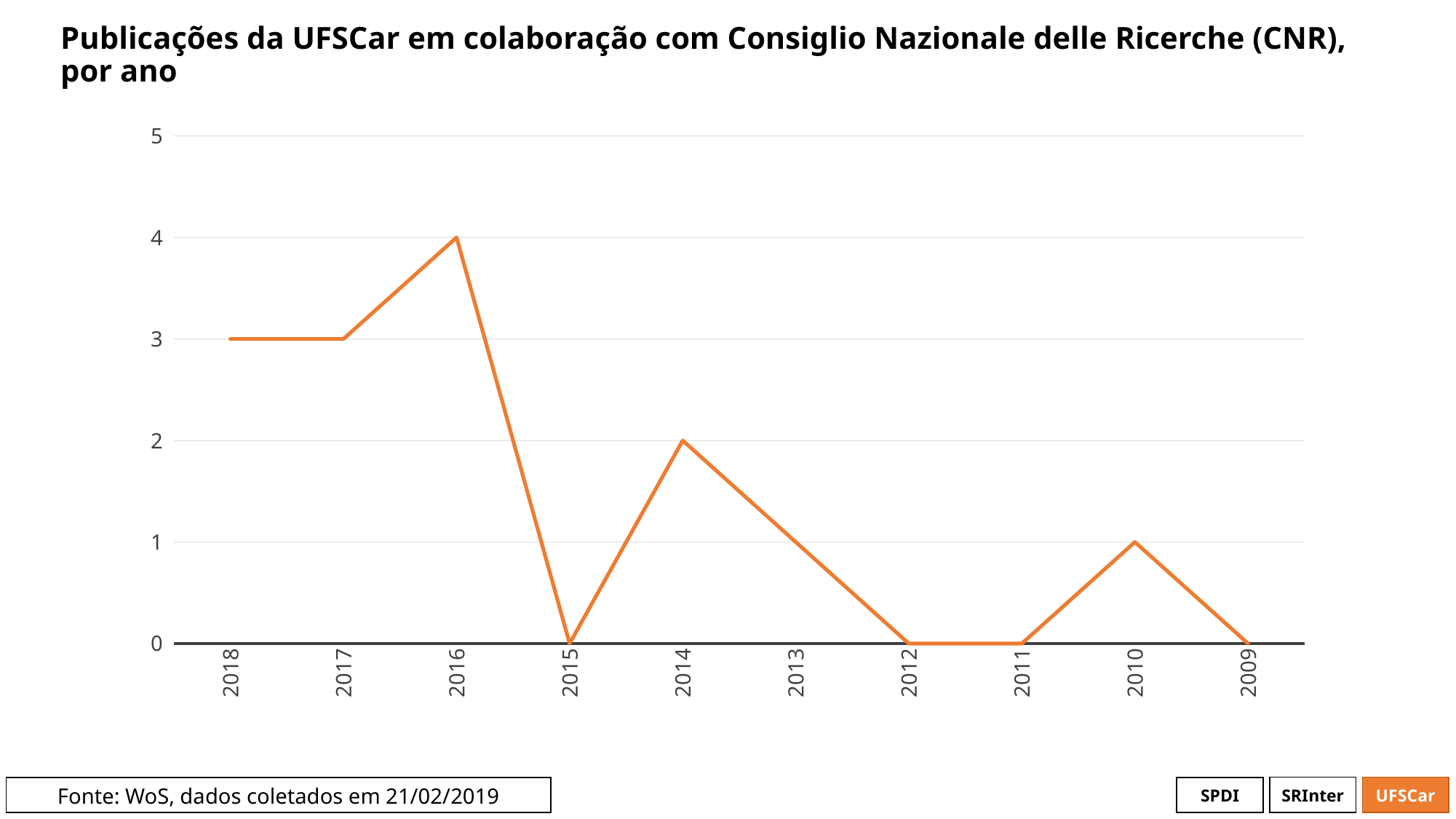
Which year has the highest value? 2016 Which is larger, the value for 2017 or the value for 2014? 2017 What is the value for 2010? 1 What is the value for 2014? 2 What is the difference between the values for 2016 and 2014? 2 What is the value for 2016? 4 What is the value for 2018? 3 What is the value for 2015? 0 What is the lowest value plotted on the chart? 0 How many years are plotted on the x axis? 10 What is the source cited at the bottom of the slide? WoS, dados coletados em 21/02/2019 What type of chart is shown on the slide? line chart